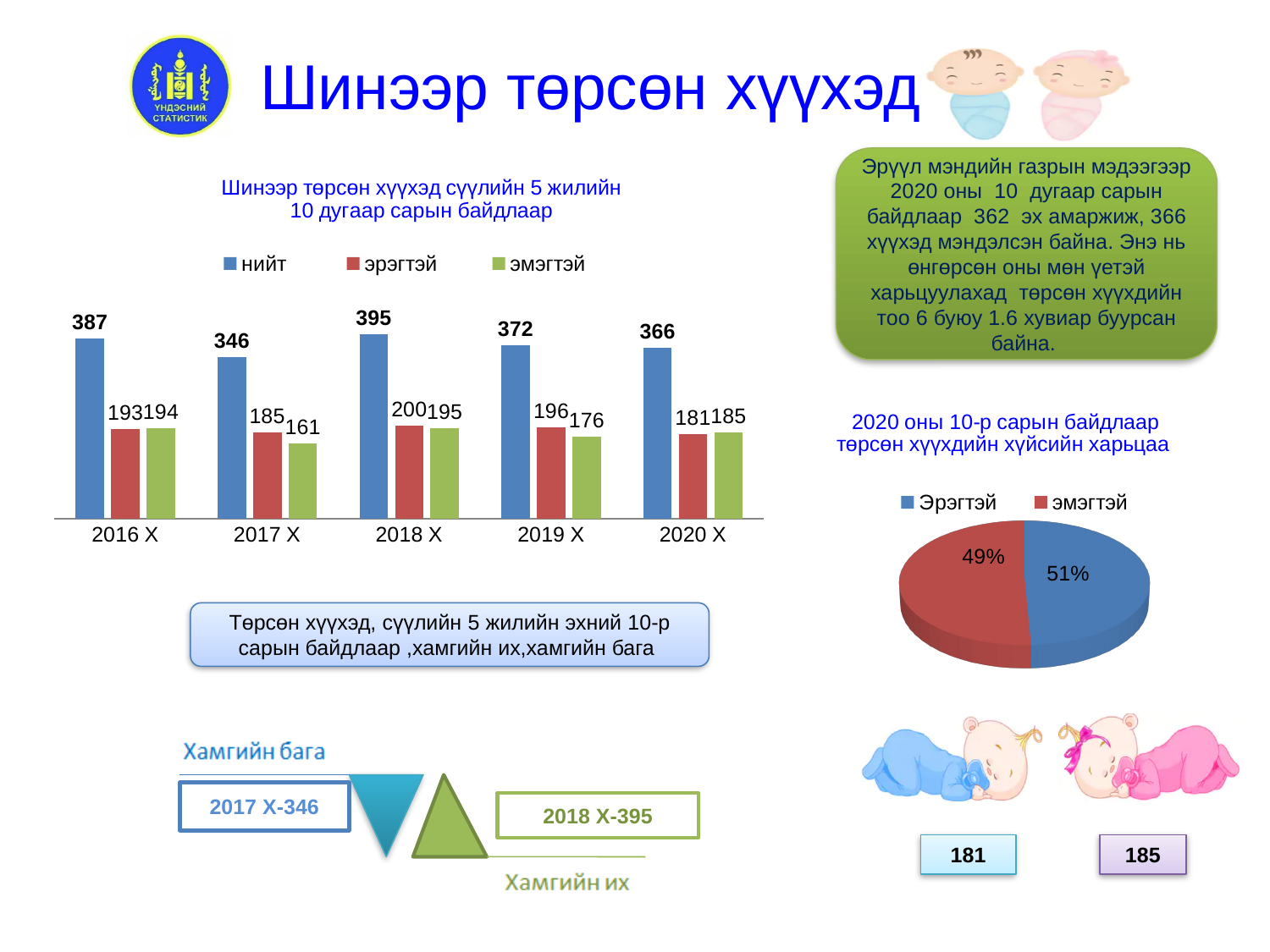
In the bar chart on the left, how many series does the legend list? 3 What kind of chart is the chart on the left? bar chart In the bar chart on the left, what is the value of эмэгтэй for 2017 X? 161 In the bar chart on the left, how many years are shown on the x axis? 5 In the bar chart on the left, what is the value of нийт for 2018 X? 395 In the bar chart on the left, what is the value of эрэгтэй for 2020 X? 181 In the bar chart on the left, which year has the highest нийт value? 2018 X In the bar chart on the left, what is the difference between the нийт values for 2018 X and 2017 X? 49 In the bar chart on the left, which year has the lowest нийт value? 2017 X In the bar chart on the left, which is larger for 2019 X: эрэгтэй or эмэгтэй? эрэгтэй In the pie chart on the right, what share does Эрэгтэй have? 51%